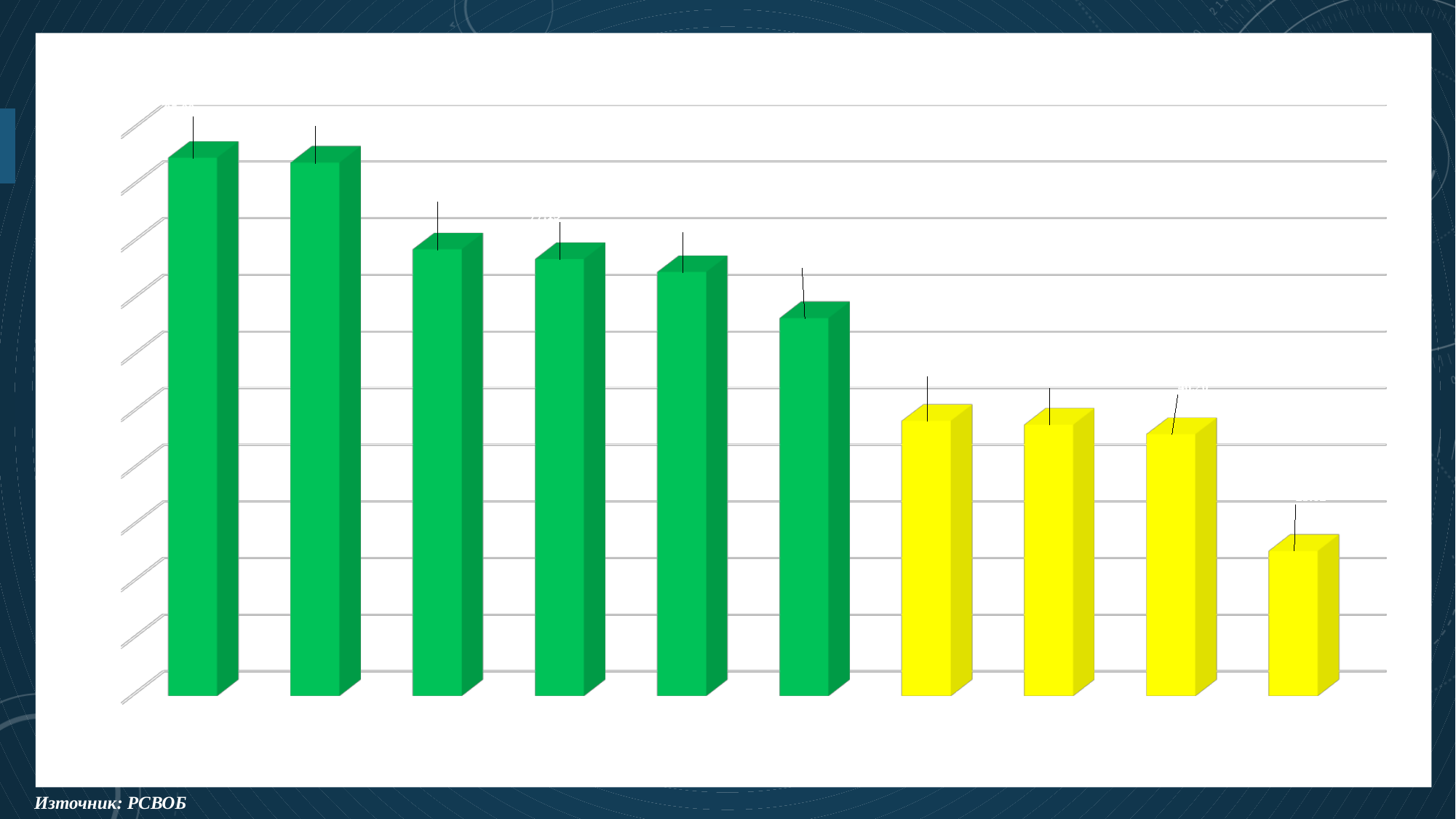
How many green bars are there in the chart? 6 Do the bar values rise or fall from left to right across the chart? fall What two colours are used for the bars in the chart? green and yellow How many bars does the chart contain? 10 What kind of chart is shown on the slide? bar chart Which is larger, the sixth bar from the left or the ninth bar from the left? the sixth bar from the left Which is larger, the third bar from the left or the seventh bar from the left? the third bar from the left Which bar is the lowest in the chart? the rightmost (tenth) bar Which is larger, the first bar from the left or the last bar on the right? the first bar from the left What source is cited at the bottom of the slide? РСВОБ How many yellow bars are there in the chart? 4